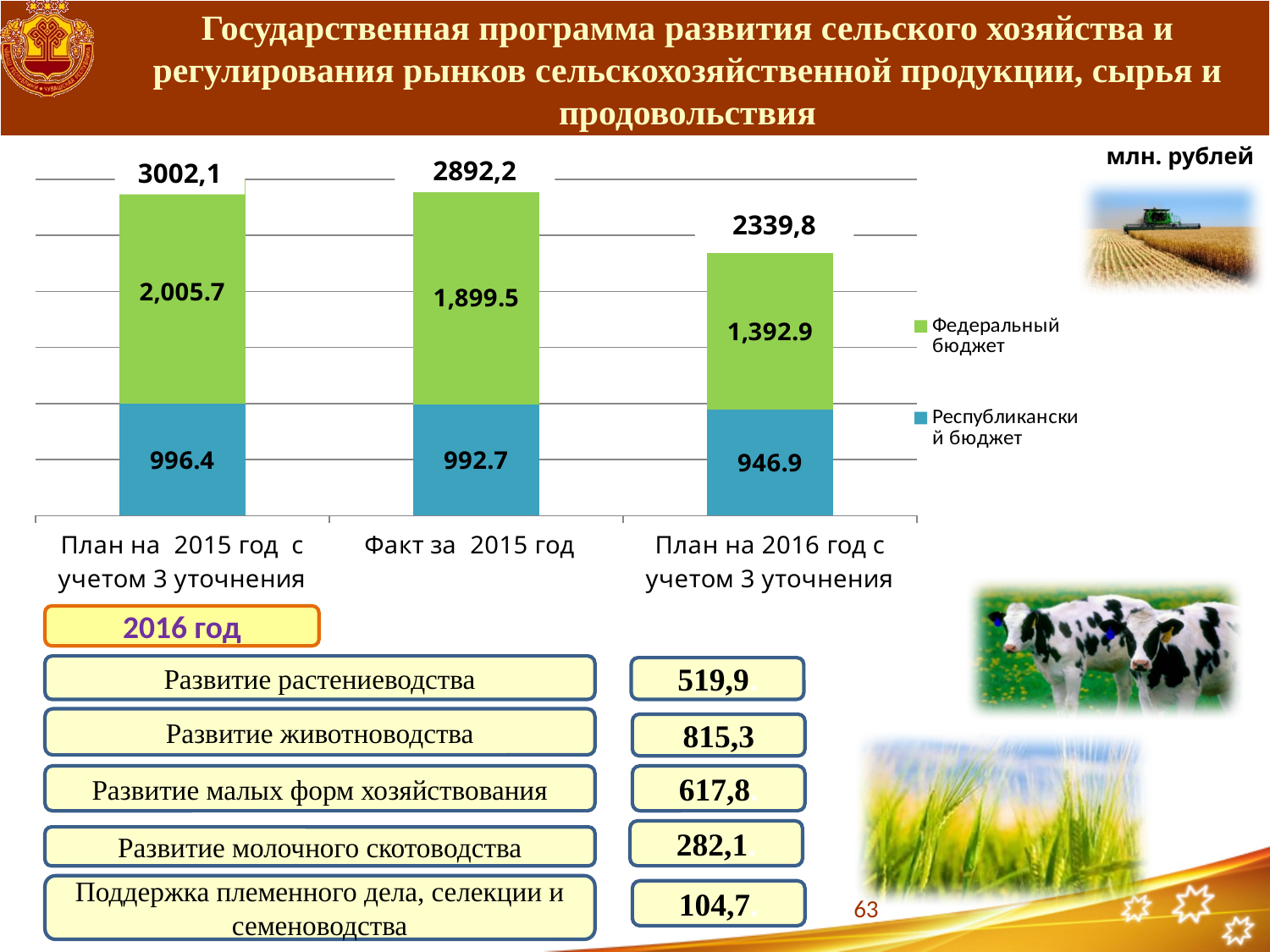
Which is larger: Республиканский бюджет for Факт за 2015 год or for План на 2016 год с учетом 3 уточнения? Факт за 2015 год How many series does the chart legend list? 2 What is the value of Федеральный бюджет for Факт за 2015 год? 1,899.5 Which category has the highest total value? План на 2015 год с учетом 3 уточнения What is the difference between the Федеральный бюджет values for План на 2015 год с учетом 3 уточнения and Факт за 2015 год? 106.2 What is the value of Республиканский бюджет for План на 2015 год с учетом 3 уточнения? 996.4 How many categories are shown on the x axis of the chart? 3 Which category has the lowest value for Федеральный бюджет? План на 2016 год с учетом 3 уточнения What is the value of Республиканский бюджет for План на 2016 год с учетом 3 уточнения? 946.9 What is the total of the stacked bar for Факт за 2015 год? 2892,2 What type of chart is shown on the slide? stacked bar chart Do the total values rise or fall from left to right across the categories? fall